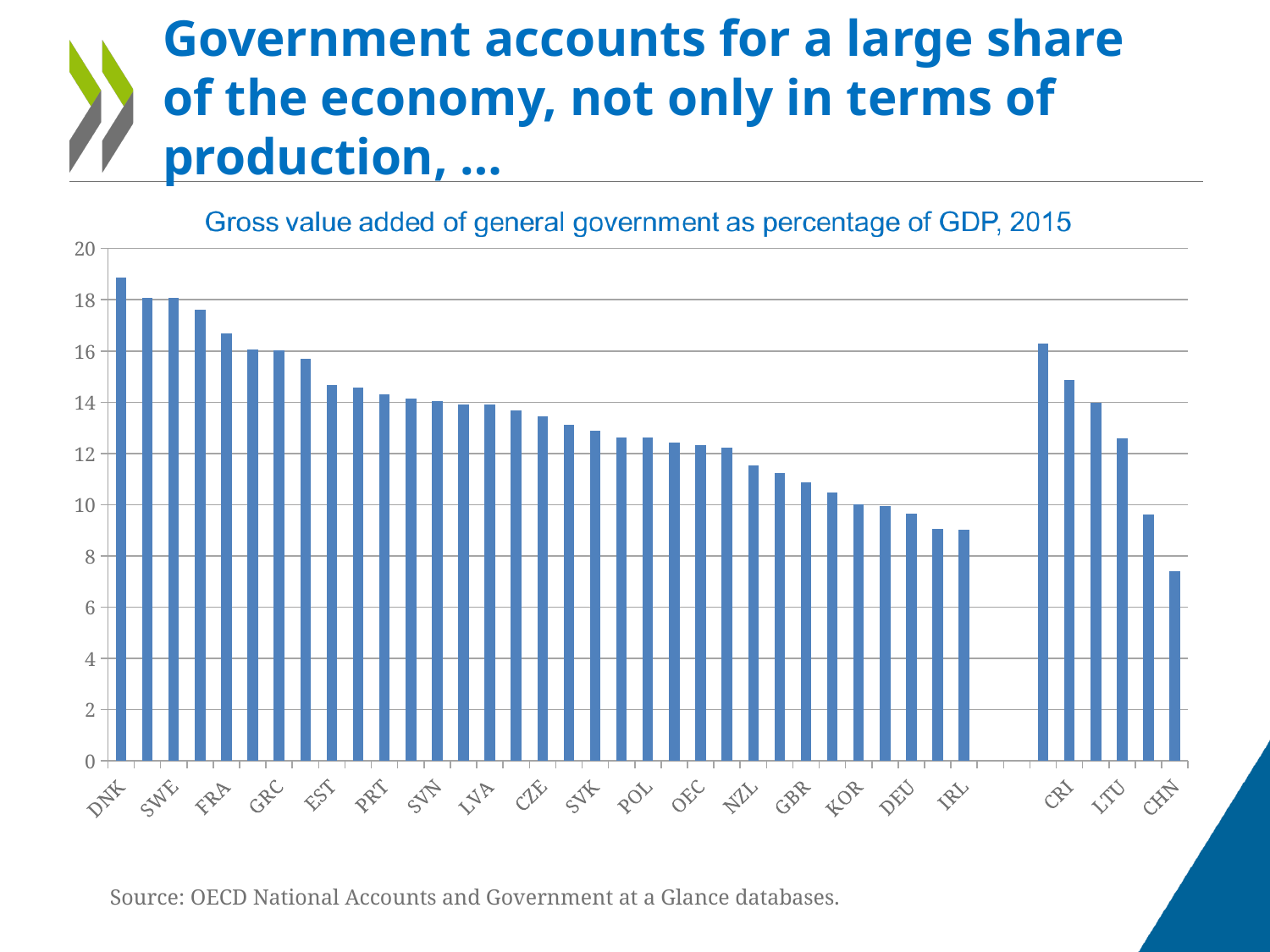
Do the values for the countries from DNK to IRL rise or fall from left to right? fall What is the title of the chart? Gross value added of general government as percentage of GDP, 2015 Which has a larger value, DNK or IRL? DNK Is the value for CHN greater or less than 10? less Which labelled country has the lowest gross value added of general government as a percentage of GDP? CHN Is the value for DNK greater or less than 18? greater Is the value for CZE greater or less than 14? less What kind of chart is shown on the slide? bar chart Which country has the highest gross value added of general government as a percentage of GDP? DNK